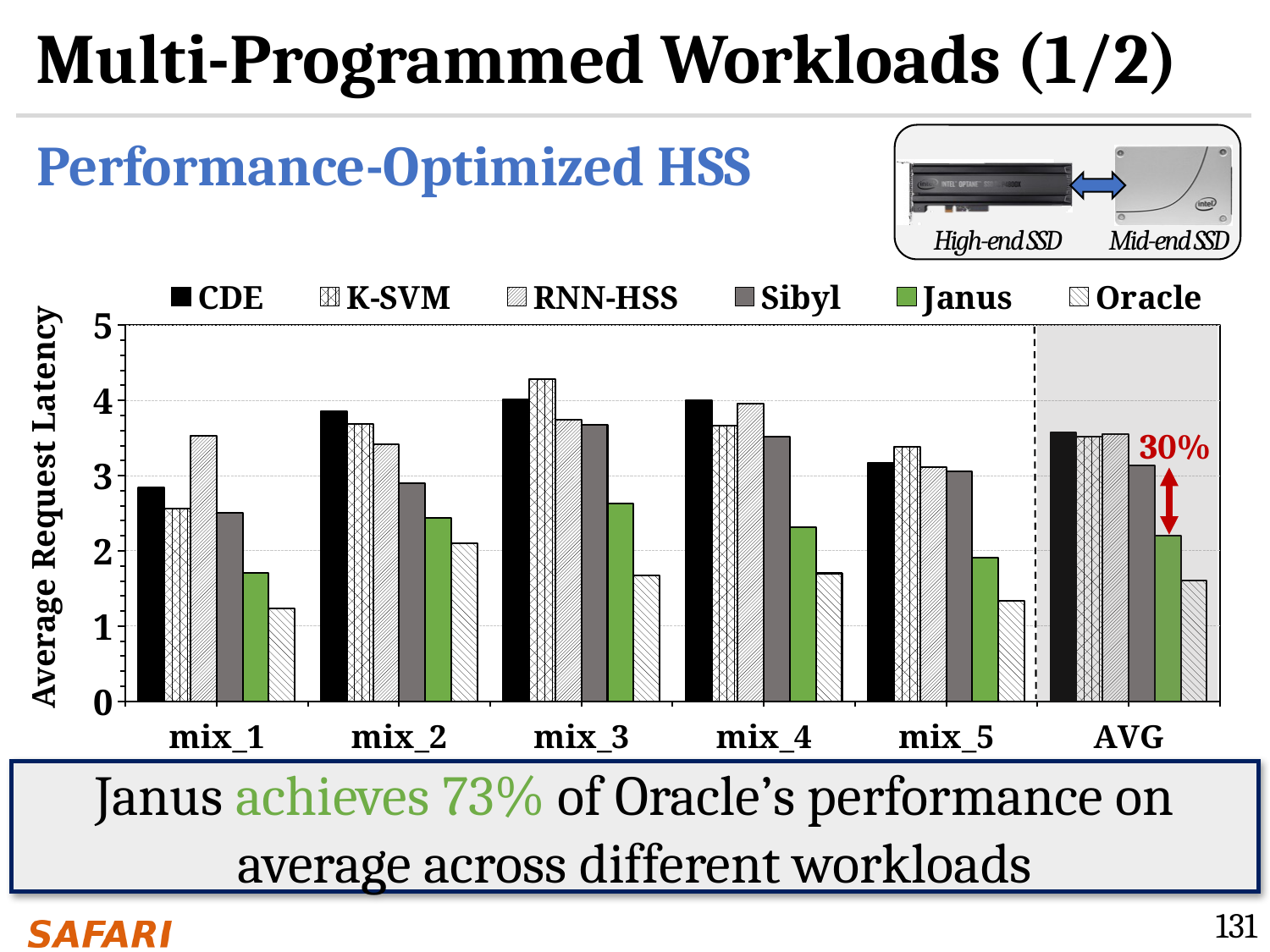
Is the Janus value for mix_1 greater or less than 2? less What percentage is annotated in red between the Janus and Sibyl bars in the AVG group? 30% What is the label of the y axis of the chart? Average Request Latency Which series has the highest average request latency for mix_3? K-SVM Which series has the lowest average request latency for mix_3? Oracle For mix_1, which is larger: the RNN-HSS value or the CDE value? RNN-HSS Which series has the highest average request latency for mix_1? RNN-HSS What kind of chart is shown on the slide? bar chart Is the K-SVM value for mix_3 greater or less than 4? greater How many series does the legend of the chart list? 6 Is the CDE value for mix_4 greater or less than 3? greater How many workload categories are shown along the x axis of the chart? 6